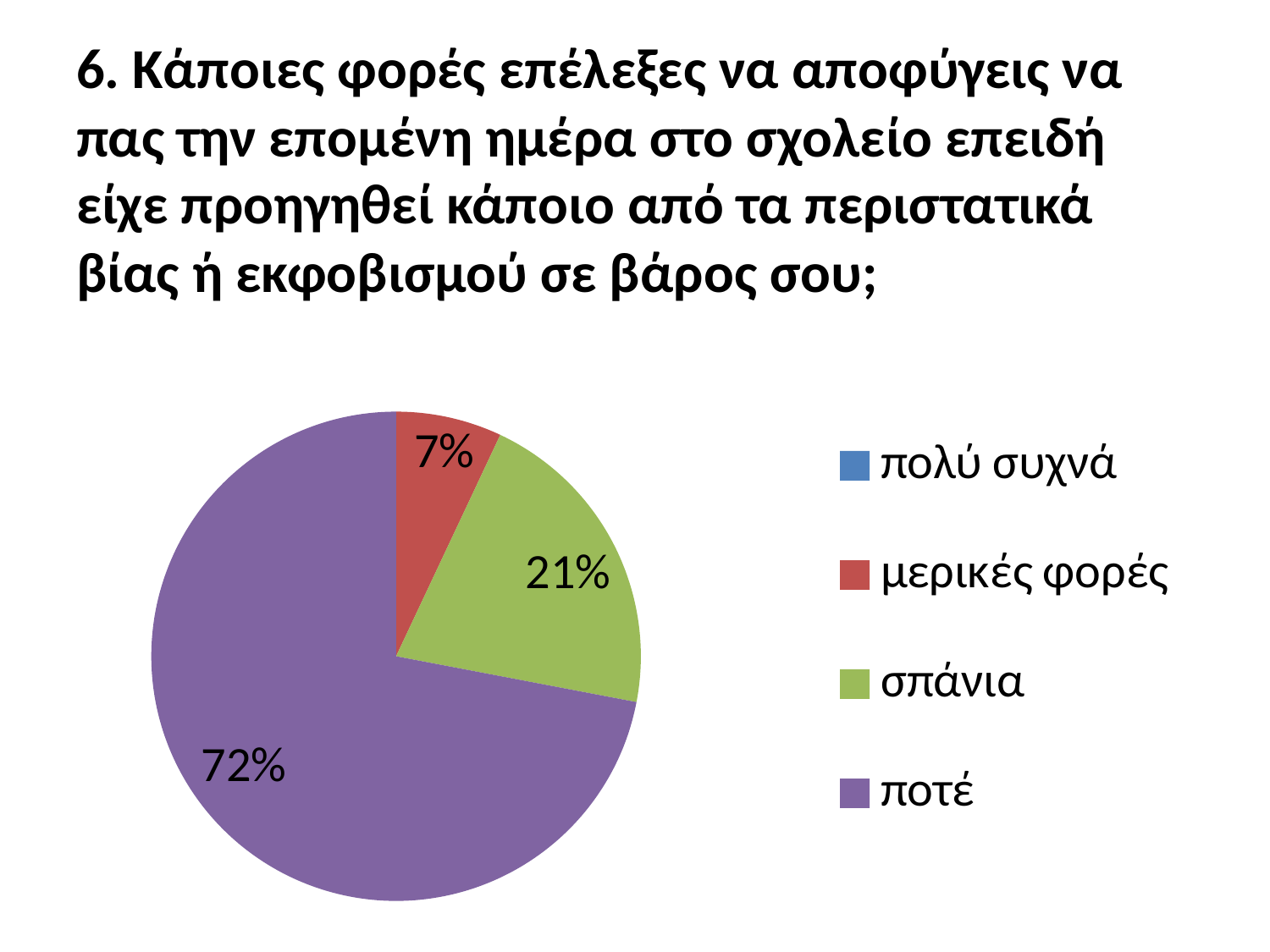
Which is larger, the slice for 'σπάνια' or the slice for 'μερικές φορές'? σπάνια Which category with a visible slice has the smallest share of the pie? μερικές φορές What kind of chart is shown on the slide? pie chart What percentage of the pie is labelled for 'ποτέ'? 72% What is the difference in percentage points between the 'ποτέ' slice and the 'σπάνια' slice? 51 What colour is the slice for 'ποτέ'? purple Which legend entry is shown in green? σπάνια Which category has the largest slice of the pie? ποτέ What percentage of the pie is labelled for 'μερικές φορές'? 7% What is the difference in percentage points between the 'σπάνια' slice and the 'μερικές φορές' slice? 14 What percentage of the pie is labelled for 'σπάνια'? 21% How many entries does the legend list? 4